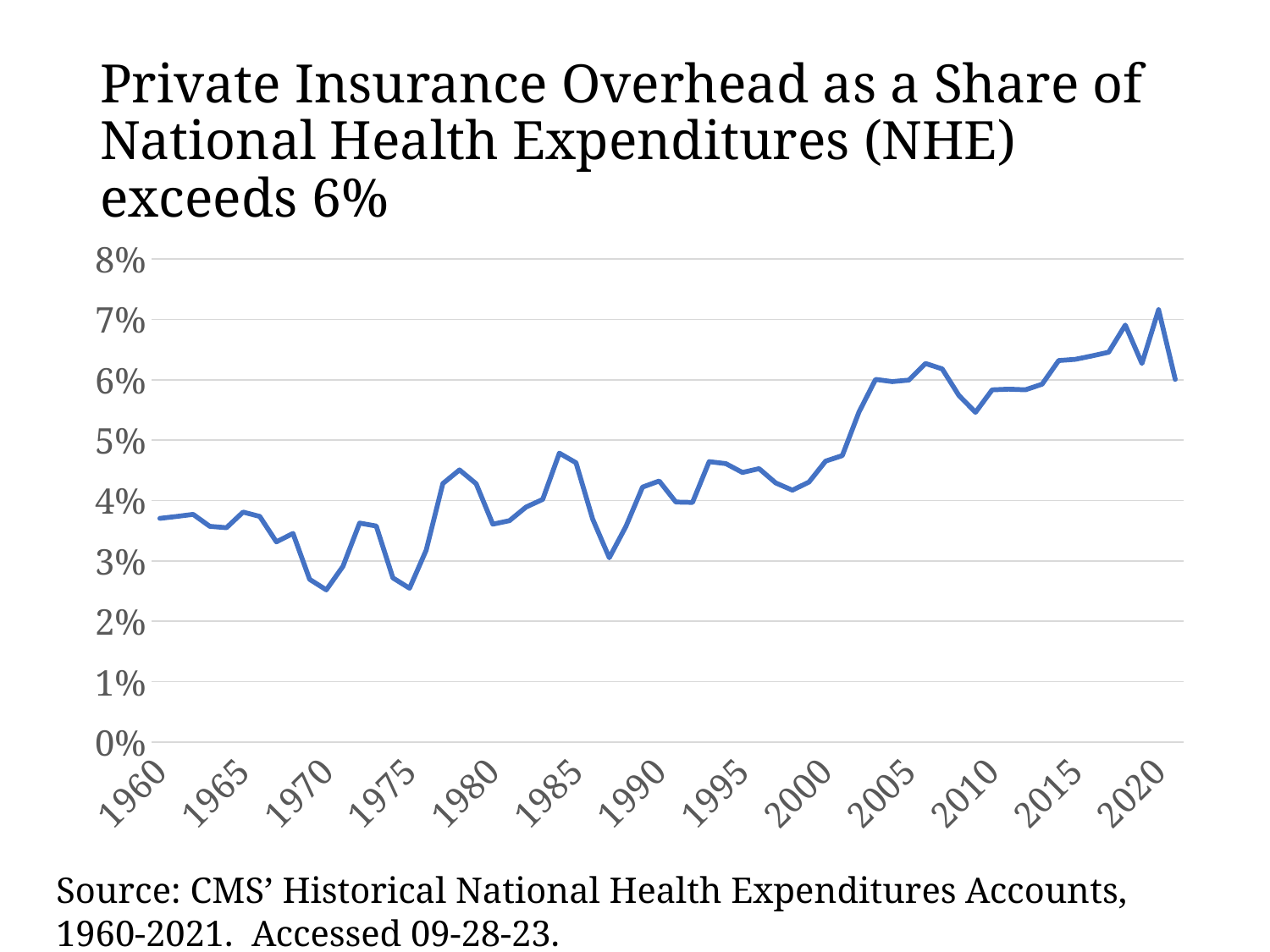
Is the value for 1970 greater or less than 3%? less Which year has the highest value on the chart? 2020 Which is larger, the value for 1970 or the value for 1985? 1985 How many year labels are shown on the x axis? 13 What is the title of the chart? Private Insurance Overhead as a Share of National Health Expenditures (NHE) exceeds 6% Is the value for 2000 greater or less than 5%? less Is the value for 2010 greater or less than 6%? less What kind of chart is shown on the slide? line chart Overall, do the values rise or fall from 1960 to 2021? rise